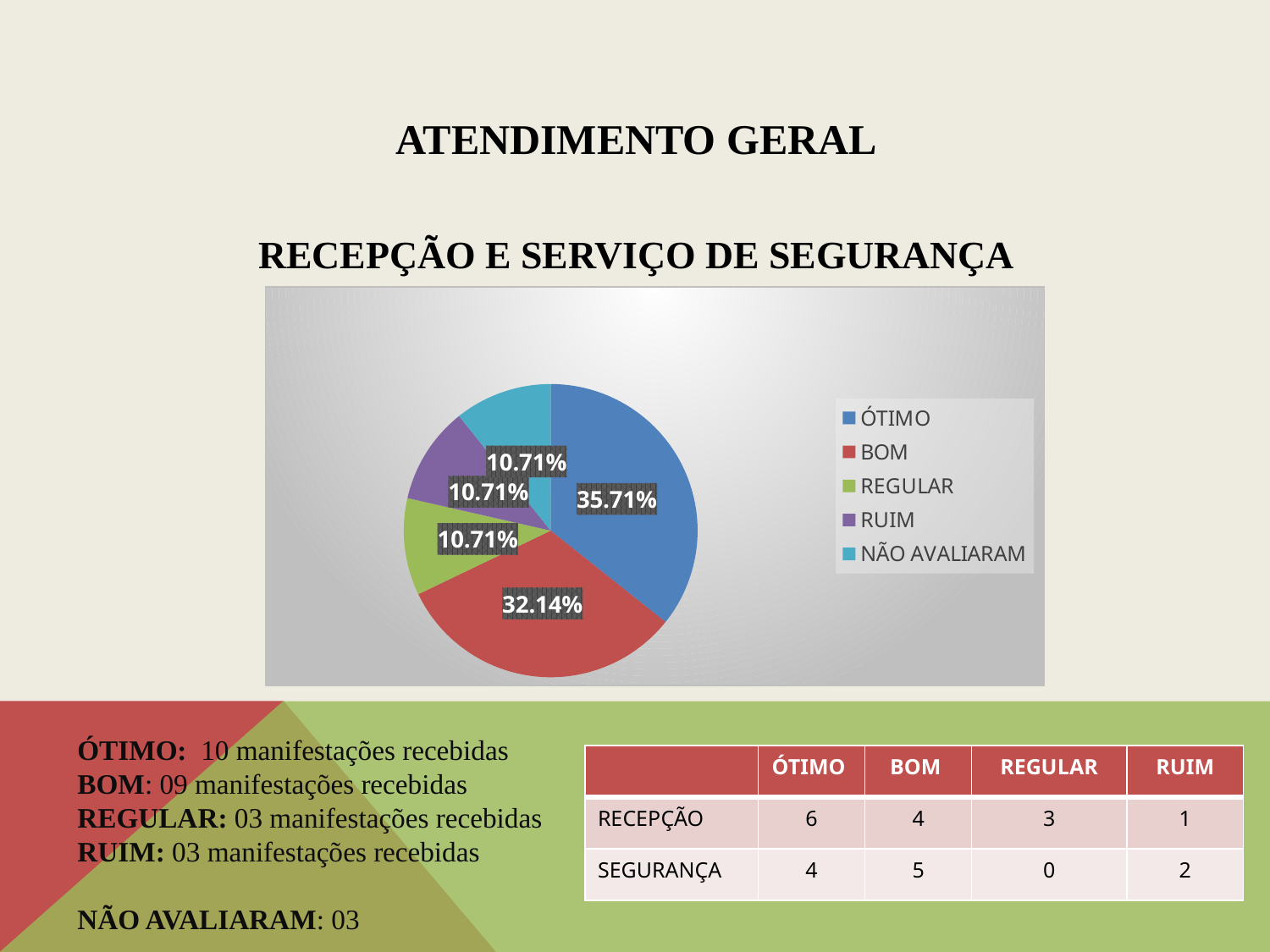
What share of the pie does ÓTIMO represent? 35.71% What share of the pie does BOM represent? 32.14% Which category has the largest slice of the pie? ÓTIMO What share of the pie does NÃO AVALIARAM represent? 10.71% What is the difference in percentage points between the ÓTIMO and BOM slices? 3.57 How many slices does the pie chart have? 5 Which legend entry is shown in red? BOM What share of the pie does REGULAR represent? 10.71% What kind of chart is shown on the slide? pie chart How many entries does the legend list? 5 Which slice is larger, ÓTIMO or BOM? ÓTIMO What is the title shown above the pie chart? RECEPÇÃO E SERVIÇO DE SEGURANÇA